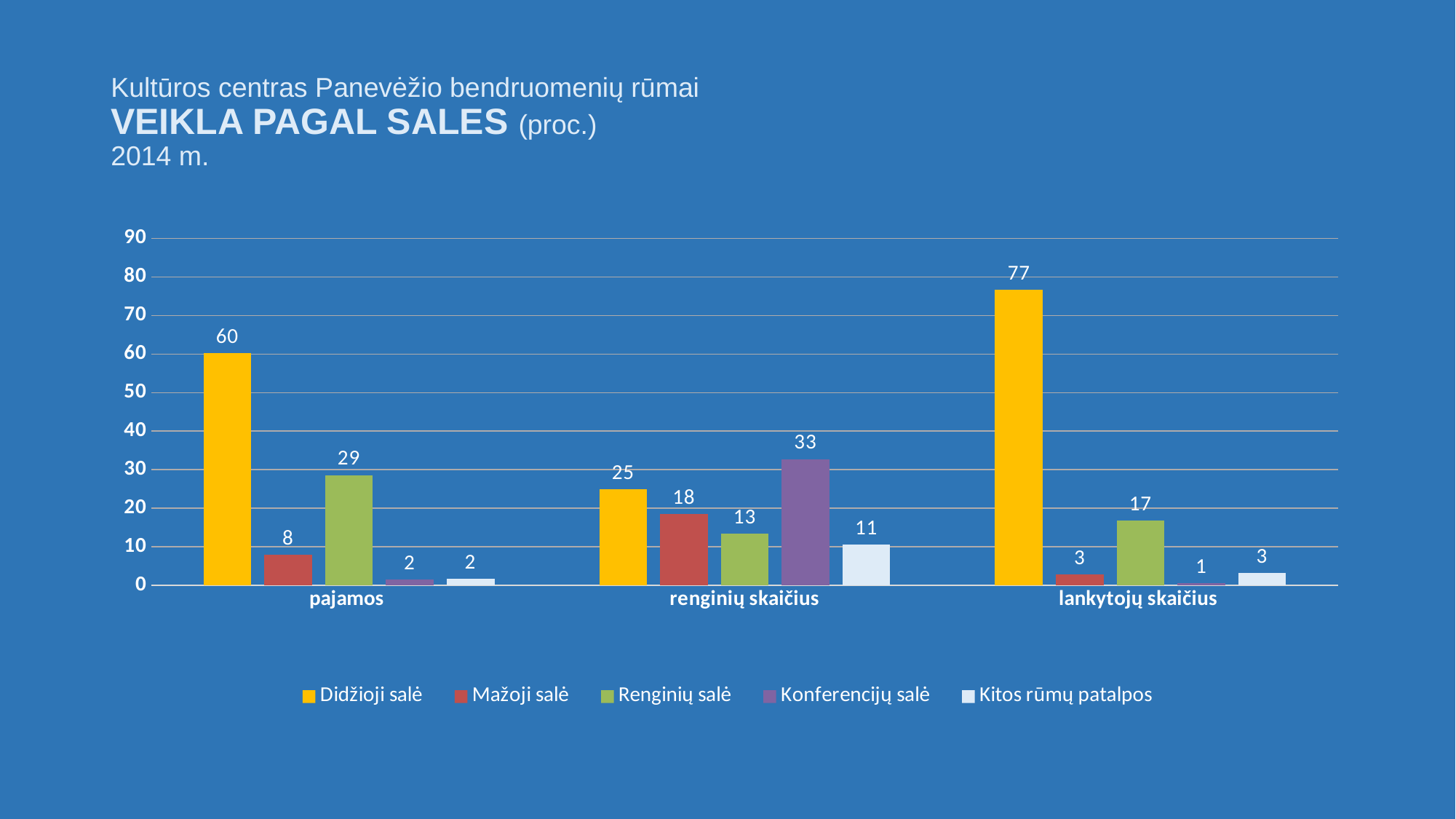
What is the difference between Didžioji salė and Renginių salė in the pajamos category? 31 What is the value for Konferencijų salė in the renginių skaičius category? 33 What is the value for Renginių salė in the lankytojų skaičius category? 17 What kind of chart is shown on the slide? bar chart How many series does the legend list? 5 Which series has the highest value in the lankytojų skaičius category? Didžioji salė Is the value for Didžioji salė in lankytojų skaičius greater or less than 70? greater Which series has the lowest value in the renginių skaičius category? Kitos rūmų patalpos Which is larger in the renginių skaičius category: Mažoji salė or Renginių salė? Mažoji salė Which colour represents Konferencijų salė in the chart? purple What is the value for Didžioji salė in the pajamos category? 60 How many categories are shown on the x axis? 3